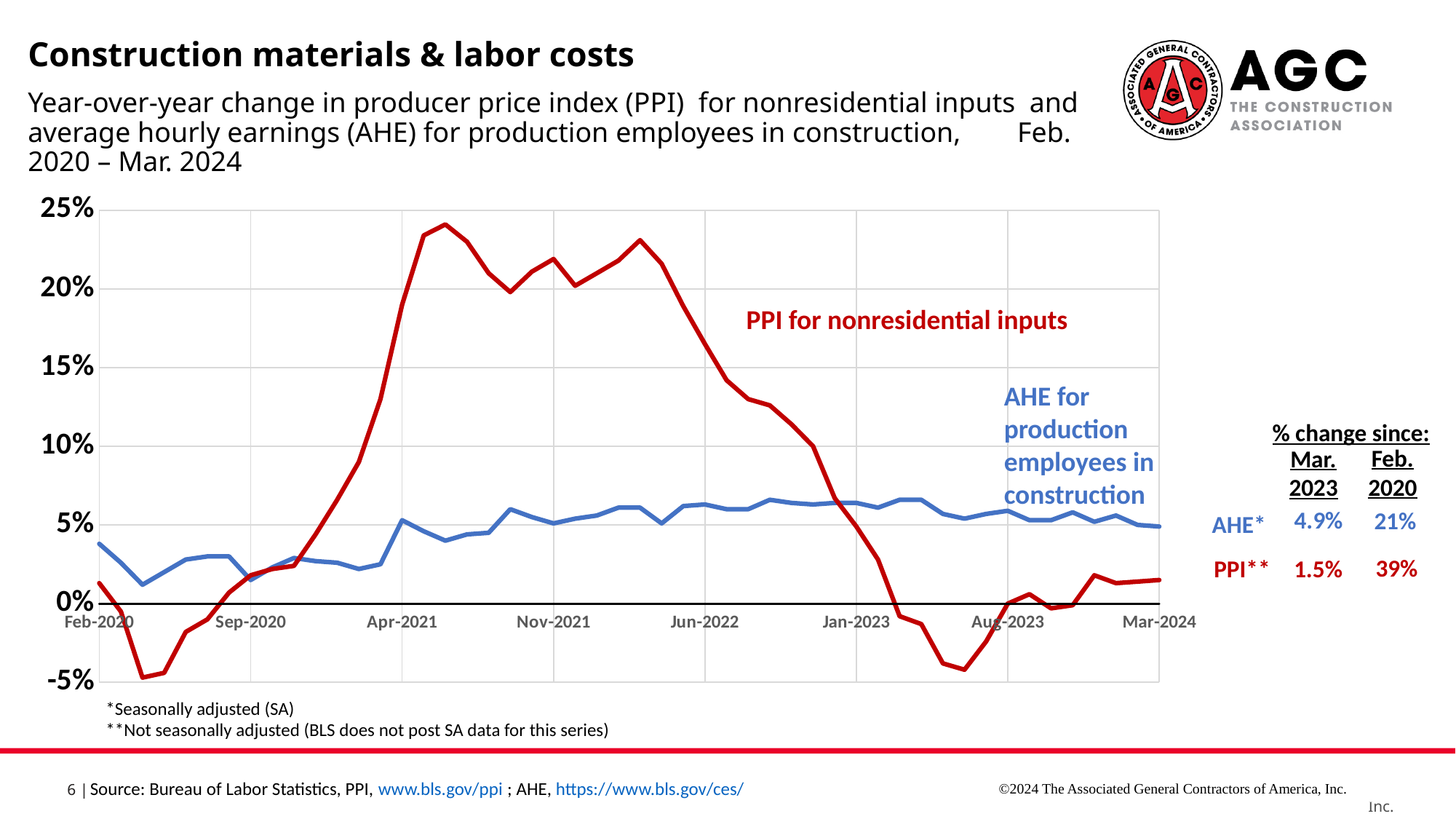
Is the peak value of the PPI for nonresidential inputs line greater or less than 20%? greater At Mar-2024, which series has the higher value, AHE for production employees in construction or PPI for nonresidential inputs? AHE for production employees in construction Which series reaches the highest value on the chart, PPI for nonresidential inputs or AHE for production employees in construction? PPI for nonresidential inputs How many data series are plotted on the chart? 2 According to the table beside the chart, what is the % change in PPI since Mar. 2023? 1.5% Which series is drawn in red on the chart? PPI for nonresidential inputs According to the table beside the chart, what is the % change in AHE since Mar. 2023? 4.9% Does the PPI for nonresidential inputs line rise or fall between Jun-2022 and Jan-2023? fall According to the table beside the chart, what is the % change in PPI since Feb. 2020? 39% What kind of chart is shown on the slide? line chart Is the lowest value of the PPI for nonresidential inputs line greater or less than 0%? less According to the table beside the chart, what is the % change in AHE since Feb. 2020? 21%